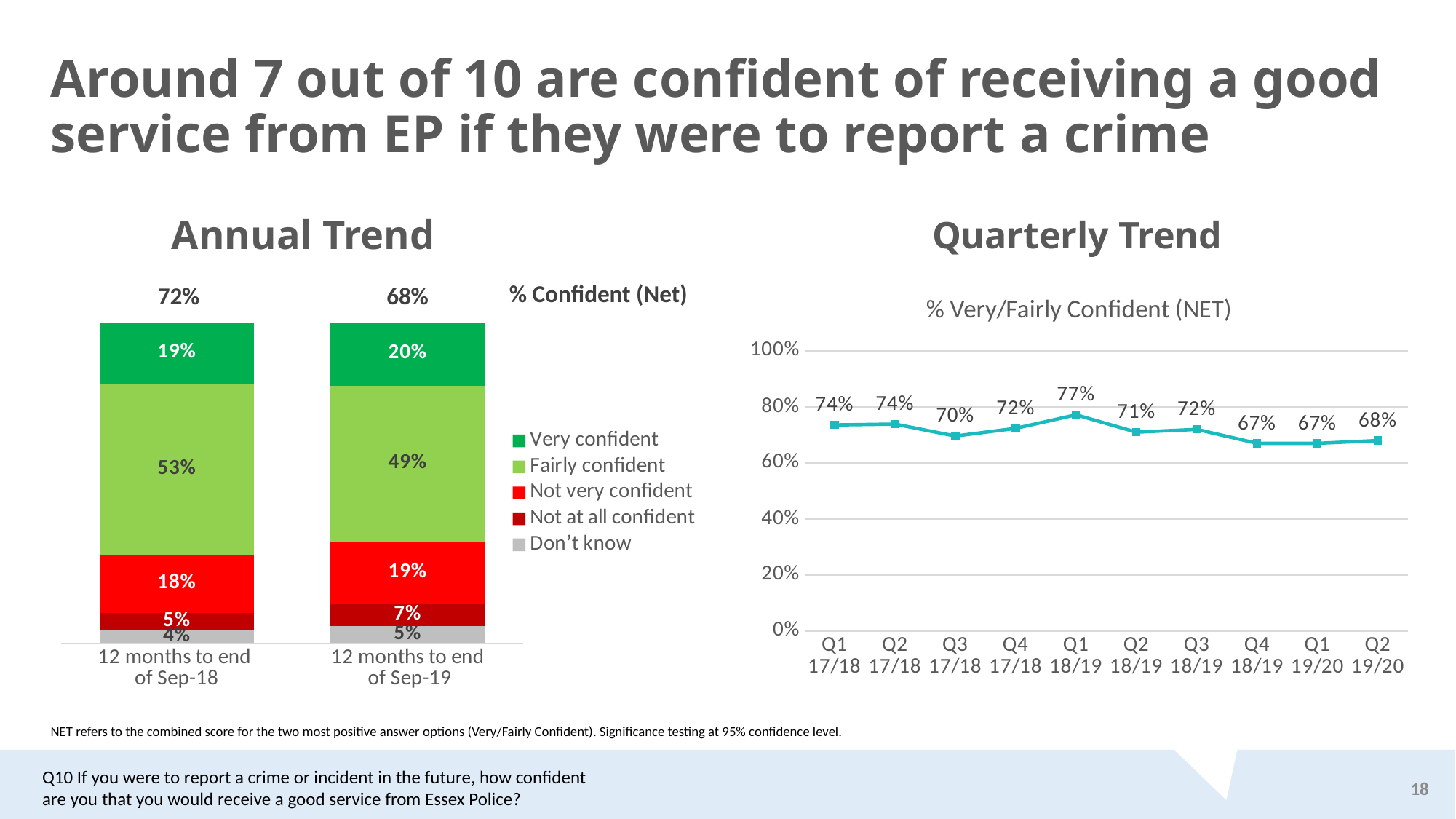
What kind of chart is the Annual Trend chart? Stacked bar chart What kind of chart is the Quarterly Trend chart? Line chart In the Quarterly Trend chart, how many quarters are plotted? 10 In the Annual Trend chart, what is the difference in the Not at all confident share between the 12 months to end of Sep-19 and the 12 months to end of Sep-18? 2% In the Quarterly Trend chart, is the value for Q3 17/18 greater or less than 80%? less In the Annual Trend chart, what is the % Confident (Net) for the 12 months to end of Sep-19? 68% In the Annual Trend chart, what percentage were Very confident in the 12 months to end of Sep-19? 20% In the Quarterly Trend chart, what is the % Very/Fairly Confident (NET) for Q1 18/19? 77% In the Annual Trend chart, how many series does the legend list? 5 In the Annual Trend chart, what percentage were Fairly confident in the 12 months to end of Sep-18? 53% In the Quarterly Trend chart, which quarter has the highest % Very/Fairly Confident (NET)? Q1 18/19 In the Quarterly Trend chart, what is the difference between the Q1 18/19 value and the Q2 19/20 value? 9%